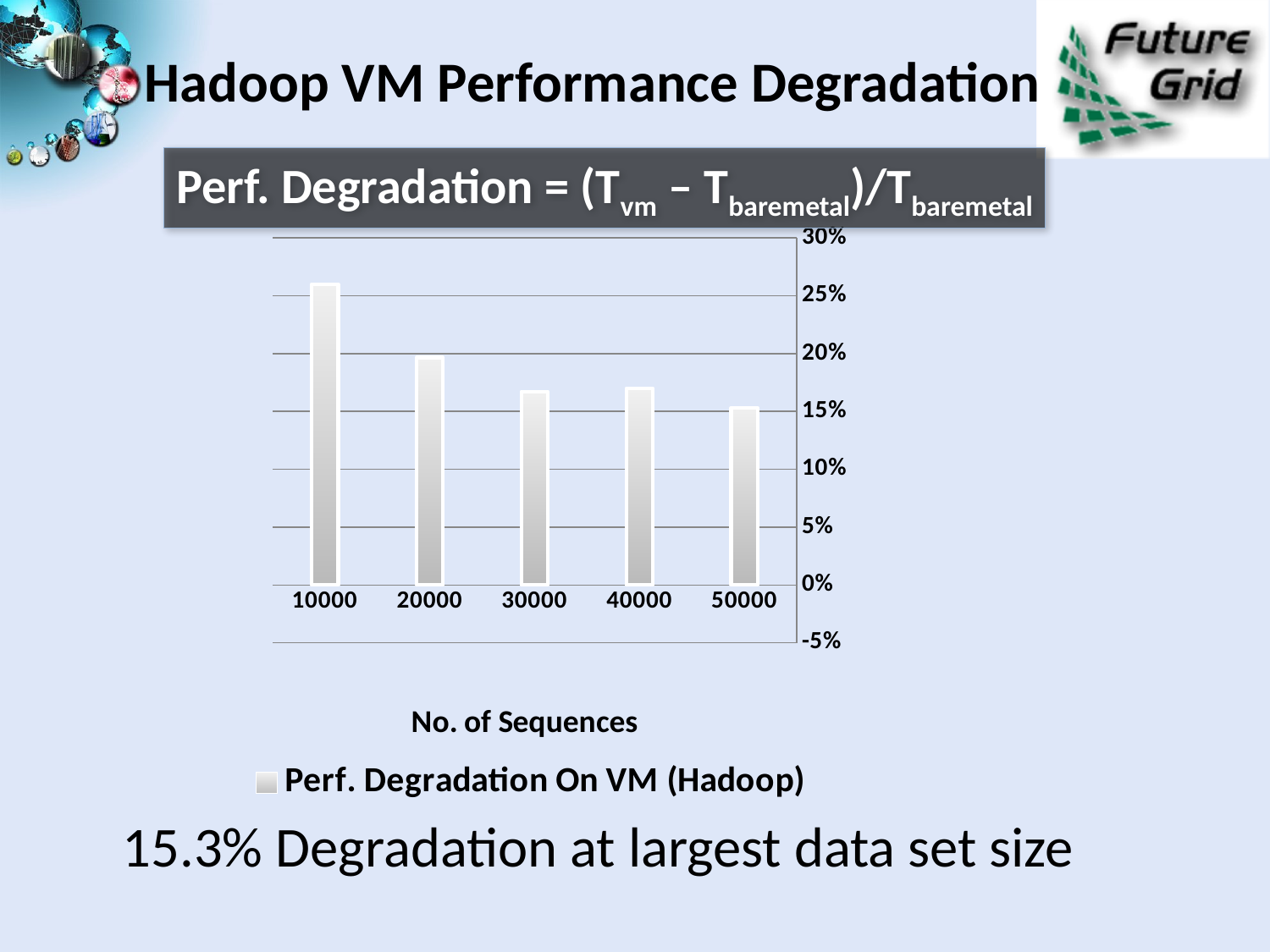
Is the value for 20000 sequences greater or less than 25%? less What is the performance degradation at the largest data set size (50000 sequences)? 15.3% How many categories (numbers of sequences) are plotted on the x axis? 5 Is the value for 30000 sequences greater or less than 20%? less Which has the larger performance degradation, 10000 or 20000 sequences? 10000 How many series does the legend list? 1 Is the value for 10000 sequences greater or less than 20%? greater Does the performance degradation generally rise or fall as the number of sequences increases? fall What kind of chart is shown on the slide? bar chart Which number of sequences has the lowest performance degradation? 50000 Which number of sequences has the highest performance degradation? 10000